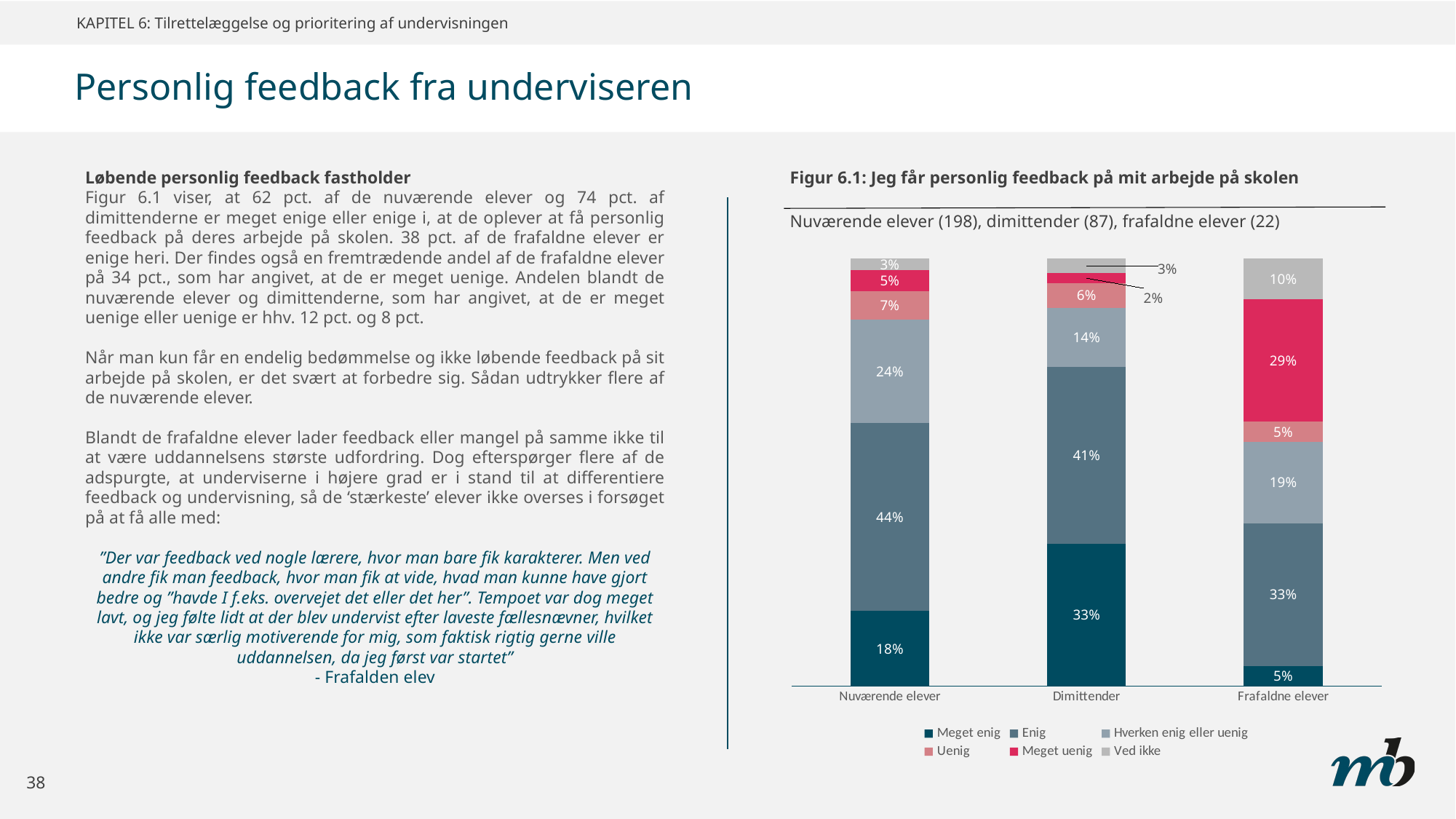
What is the value for 'Meget enig' among Nuværende elever? 18% What is the value for 'Ved ikke' among Frafaldne elever? 10% Which category has the highest value for 'Meget enig'? Dimittender What is the title of the chart? Figur 6.1: Jeg får personlig feedback på mit arbejde på skolen What kind of chart is shown in Figur 6.1? Stacked bar chart Which category has the lowest value for 'Meget uenig'? Dimittender How many series does the chart's legend list? 6 What is the difference between the 'Enig' values for Nuværende elever and Frafaldne elever? 11 percentage points What is the value for 'Enig' among Dimittender? 41% What is the value for 'Meget uenig' among Frafaldne elever? 29% How many categories are shown on the x axis of the chart? 3 Which is larger: the 'Hverken enig eller uenig' value for Nuværende elever or for Dimittender? Nuværende elever